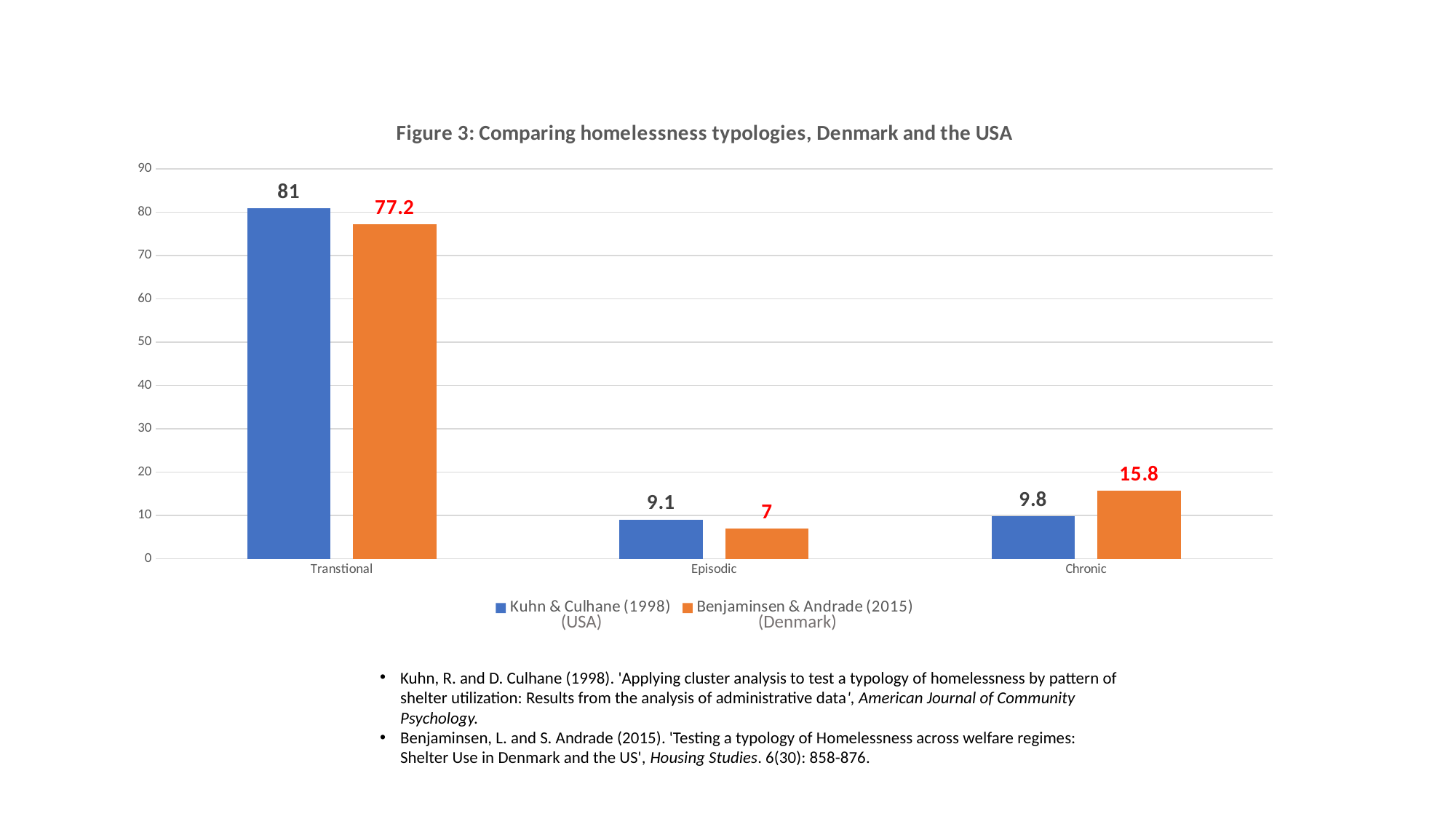
What is the value for Benjaminsen & Andrade (2015) (Denmark) in the Chronic category? 15.8 How many series does the legend list? 2 What kind of chart is shown on the slide? Bar chart What is the value for Benjaminsen & Andrade (2015) (Denmark) in the Episodic category? 7 What is the value for Kuhn & Culhane (1998) (USA) in the Transtional category? 81 What is the difference between the Kuhn & Culhane (1998) (USA) and Benjaminsen & Andrade (2015) (Denmark) values in the Transtional category? 3.8 What is the title of the chart? Figure 3: Comparing homelessness typologies, Denmark and the USA Which category has the highest value for Kuhn & Culhane (1998) (USA)? Transtional How many categories are shown on the x axis? 3 Which category has the lowest value for Benjaminsen & Andrade (2015) (Denmark)? Episodic In the Chronic category, which series has the larger value? Benjaminsen & Andrade (2015) (Denmark) Is the value for Benjaminsen & Andrade (2015) (Denmark) in the Transtional category greater or less than 70? greater